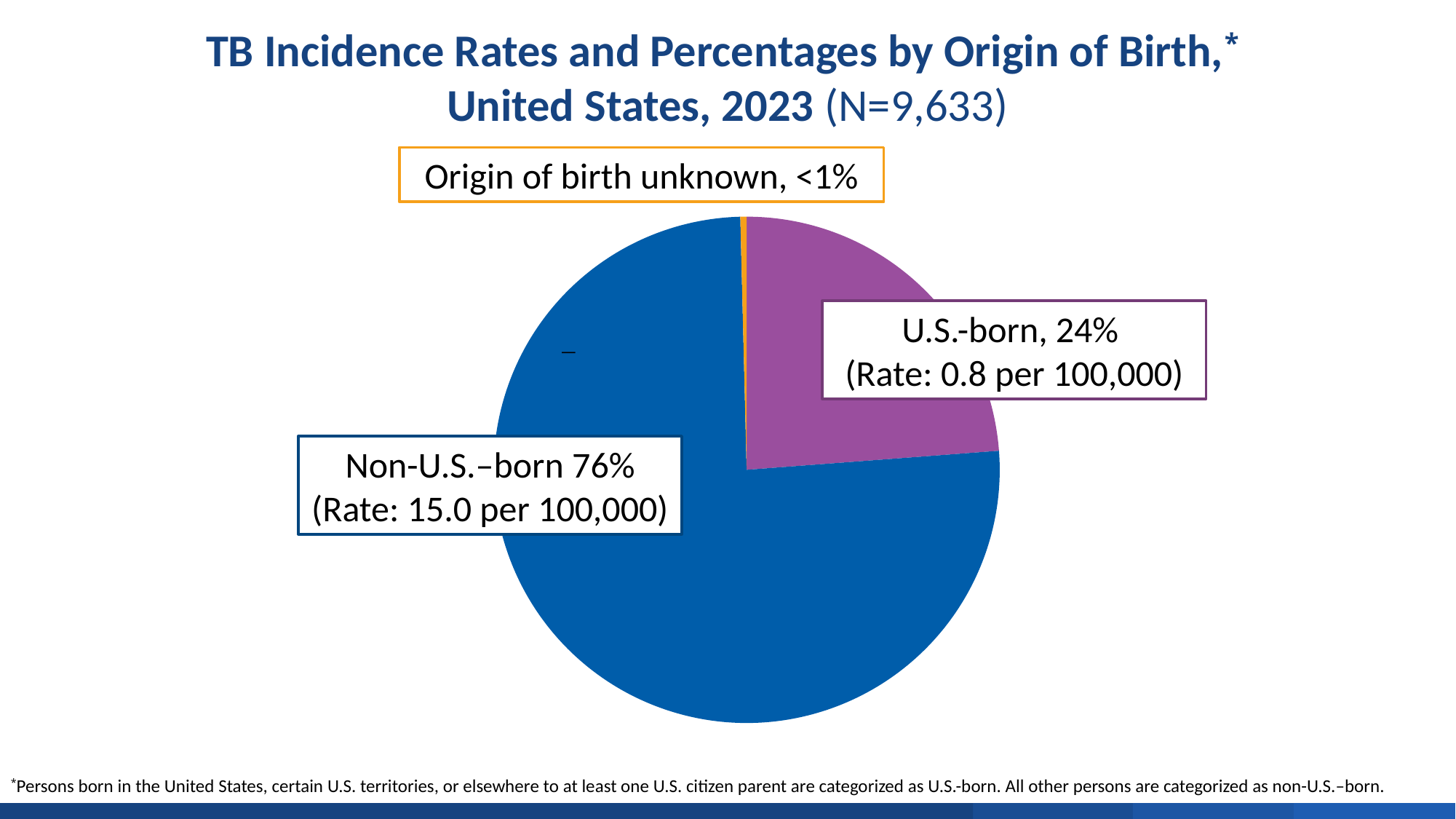
What percentage of TB cases is shown for Non-U.S.-born persons? 76% What percentage is shown for persons with origin of birth unknown? <1% How many slices does the pie chart have? 3 What kind of chart is shown on the slide? pie chart What percentage of TB cases is shown for U.S.-born persons? 24% What is the TB incidence rate shown for U.S.-born persons? 0.8 per 100,000 Which category has the largest share of the pie? Non-U.S.-born What is the total number of cases (N) given in the chart title? 9,633 Which has a higher TB incidence rate, U.S.-born or Non-U.S.-born persons? Non-U.S.-born What is the difference in percentage points between the Non-U.S.-born and U.S.-born shares? 52 Which category has the smallest share of the pie? Origin of birth unknown What is the TB incidence rate shown for Non-U.S.-born persons? 15.0 per 100,000